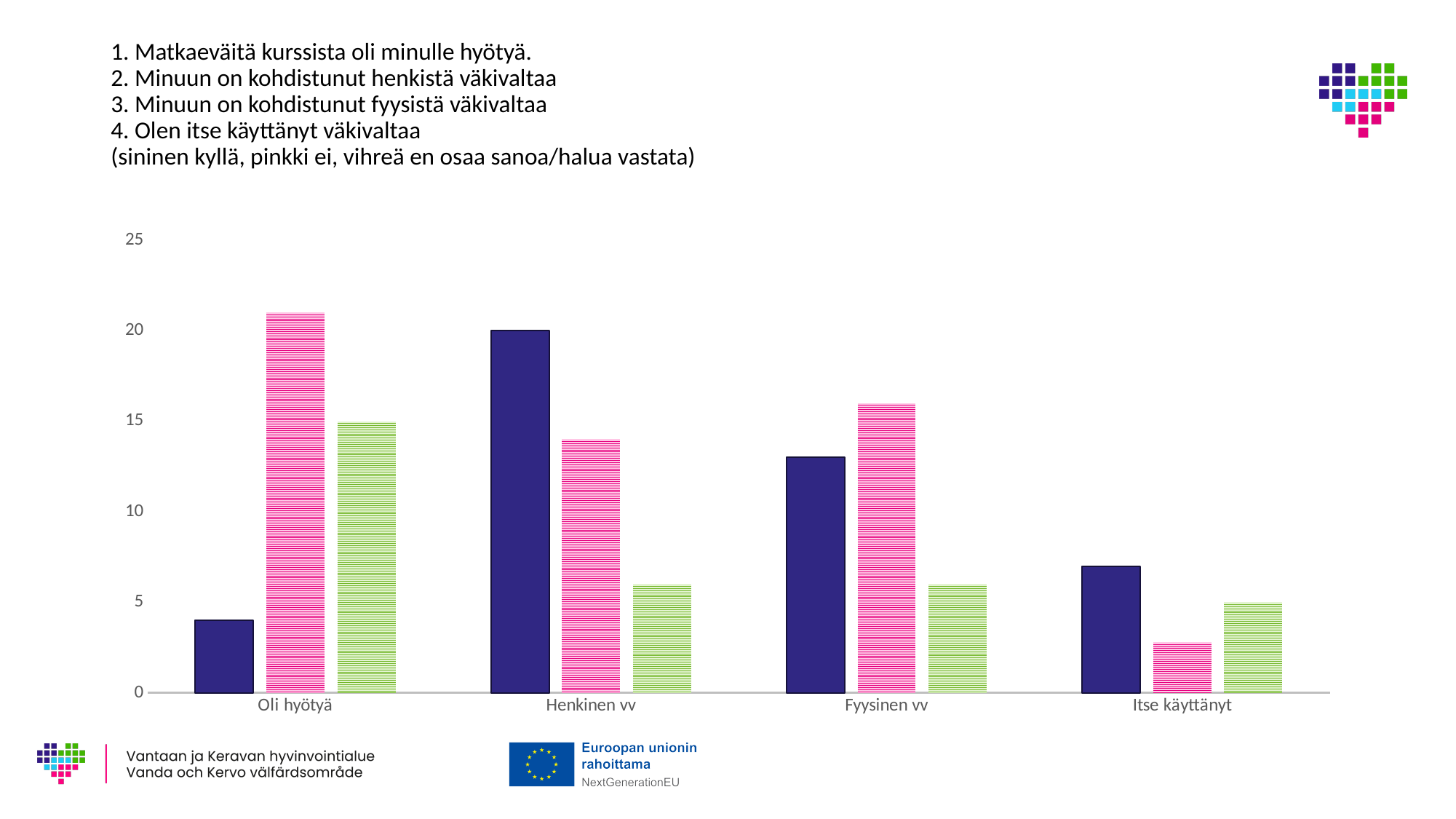
How many bars are shown for each category in the chart? 3 What kind of chart is shown on the slide? bar chart Is the value of the blue bar for Oli hyötyä greater or less than 5? less Which category has the tallest blue bar? Henkinen vv Which category has the tallest pink bar? Oli hyötyä Is the value of the pink bar for Henkinen vv greater or less than 15? less Is the value of the pink bar for Itse käyttänyt greater or less than 5? less For Fyysinen vv, which bar is taller, the blue one or the pink one? pink How many categories are shown on the x axis of the chart? 4